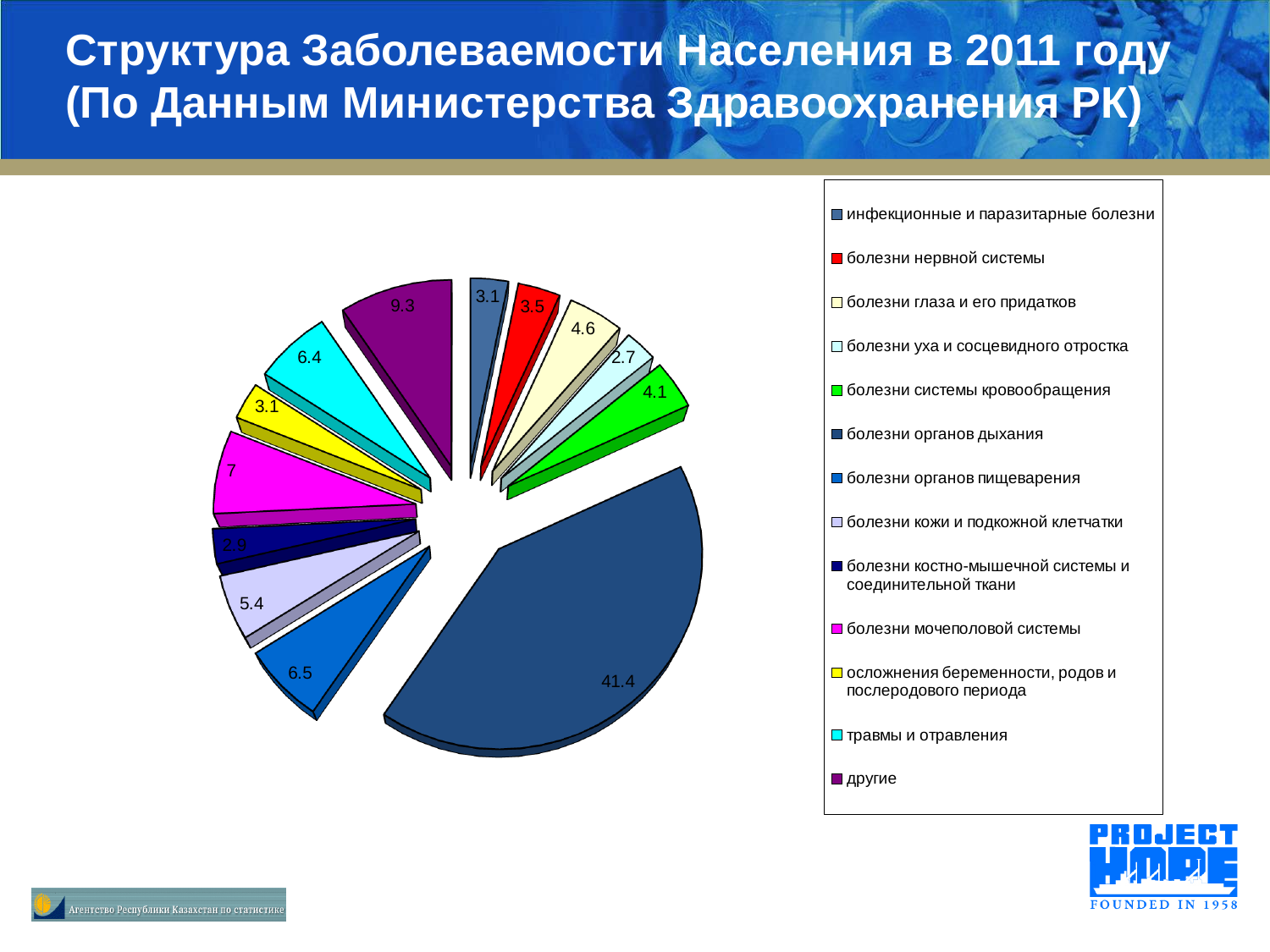
What is the value shown for болезни органов дыхания? 41.4 What kind of chart is shown on the slide? Pie chart Which is larger, the value for болезни глаза и его придатков or the value for болезни системы кровообращения? болезни глаза и его придатков How many slices does the pie chart have? 13 What is the value shown for травмы и отравления? 6.4 Which category has the smallest slice in the pie chart? болезни уха и сосцевидного отростка What is the value shown for болезни кожи и подкожной клетчатки? 5.4 What is the value shown for болезни мочеполовой системы? 7 What is the value shown for другие? 9.3 Which category has the largest slice in the pie chart? болезни органов дыхания What colour is the slice for болезни органов дыхания? Dark blue What is the difference between the values for болезни органов пищеварения and болезни нервной системы? 3